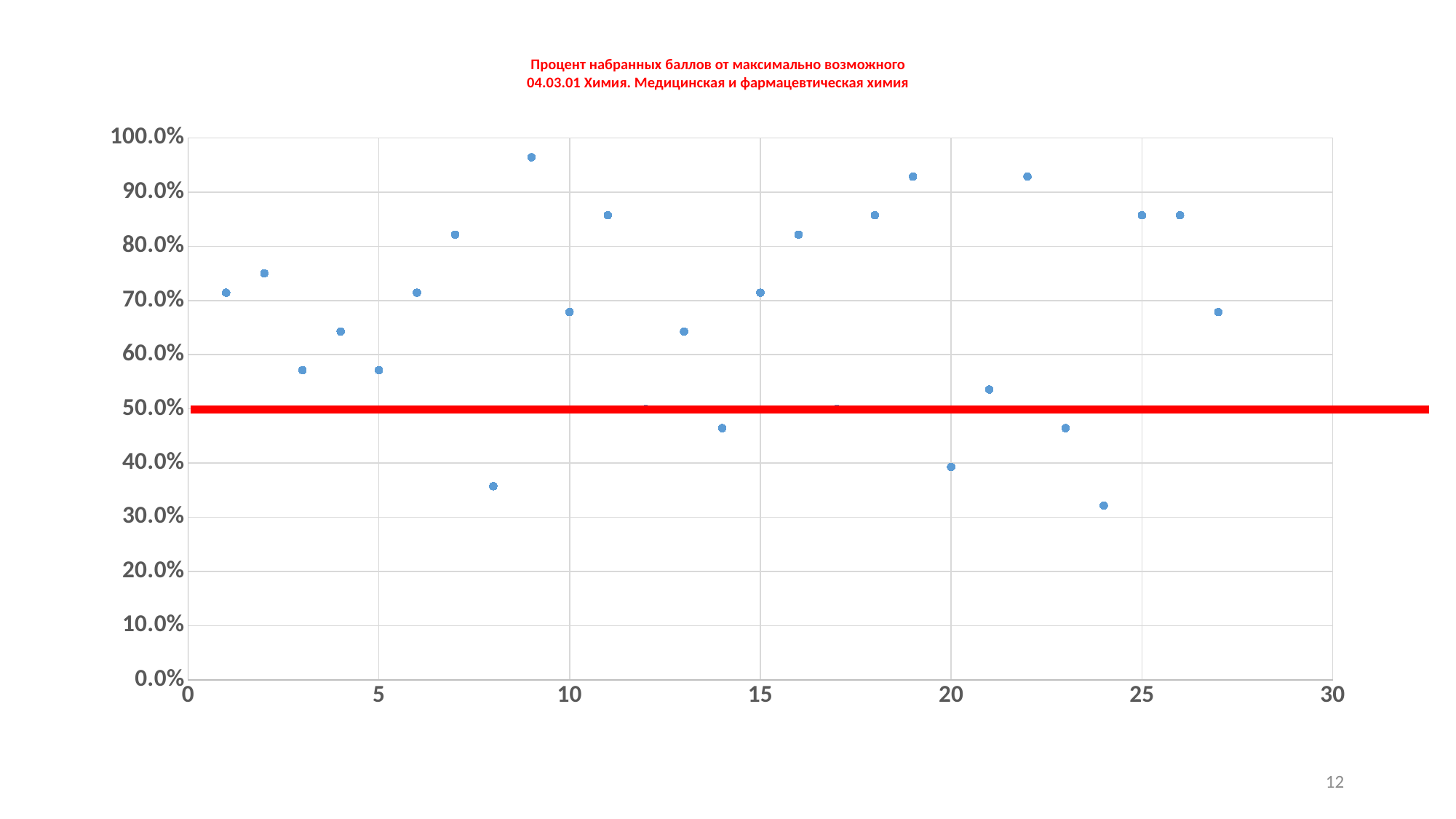
Is the value at x = 9 greater or less than 90.0%? greater What kind of chart is shown on the slide? scatter chart Is the value at x = 3 greater or less than 60.0%? less Which has the larger value, the point at x = 20 or the point at x = 21? x = 21 Is the value at x = 24 greater or less than 40.0%? less Which has the larger value, the point at x = 2 or the point at x = 3? x = 2 At which x value is the lowest point on the chart? 24 At which x value is the highest point on the chart? 9 At what level on the y axis is the thick red horizontal line drawn? 50.0%